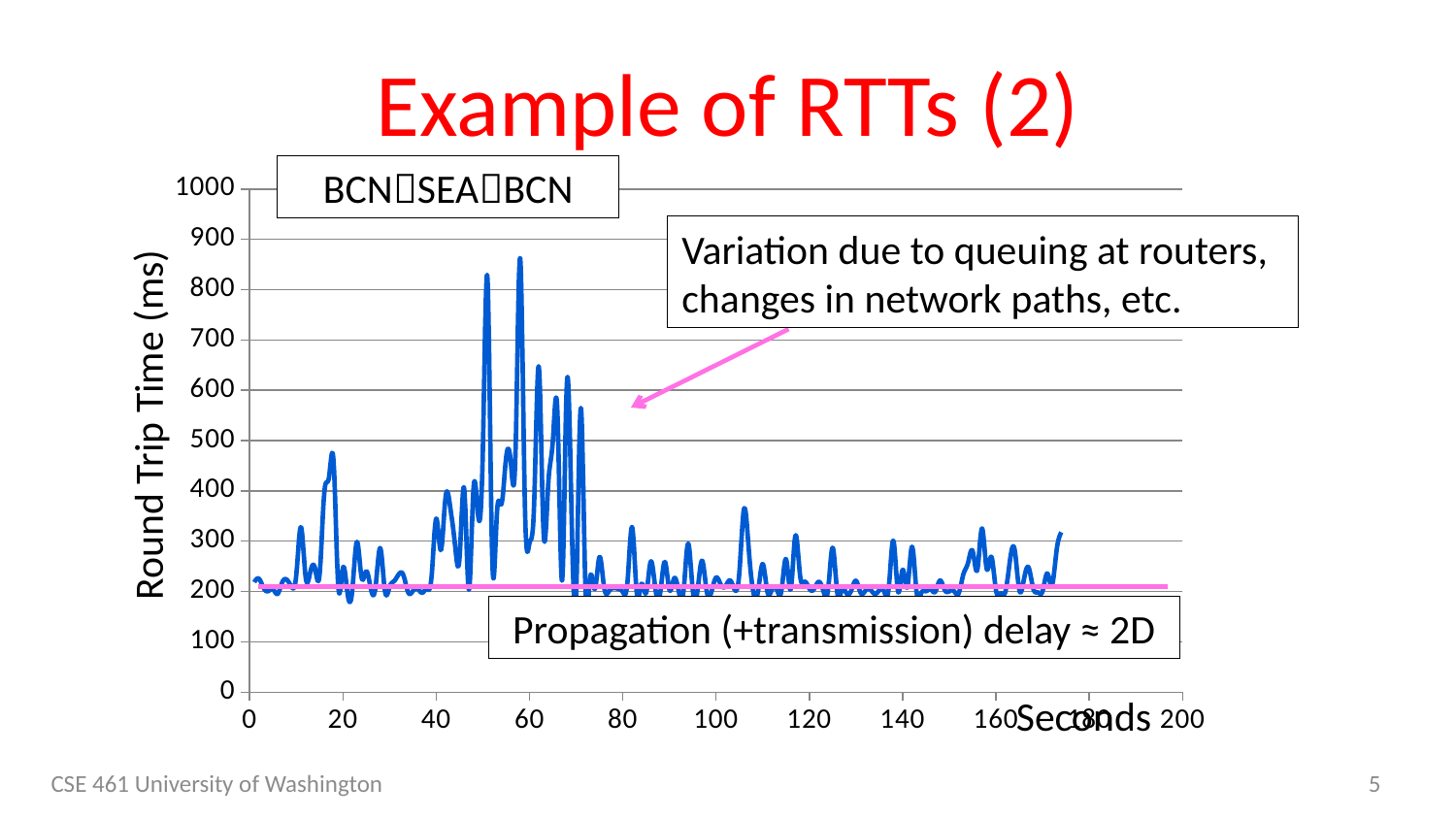
Is the round trip time at 100 seconds greater or less than 300? less What is the maximum value shown on the horizontal axis? 200 What kind of chart is shown on the slide? line chart What is the title shown in the box at the top of the chart? BCN→SEA→BCN Is the flat pink line representing propagation delay greater or less than 300 ms? less Is the peak in round trip time near 20 seconds greater or less than 400? greater What is the maximum value shown on the vertical axis? 1000 What is the label on the vertical axis of the chart? Round Trip Time (ms)